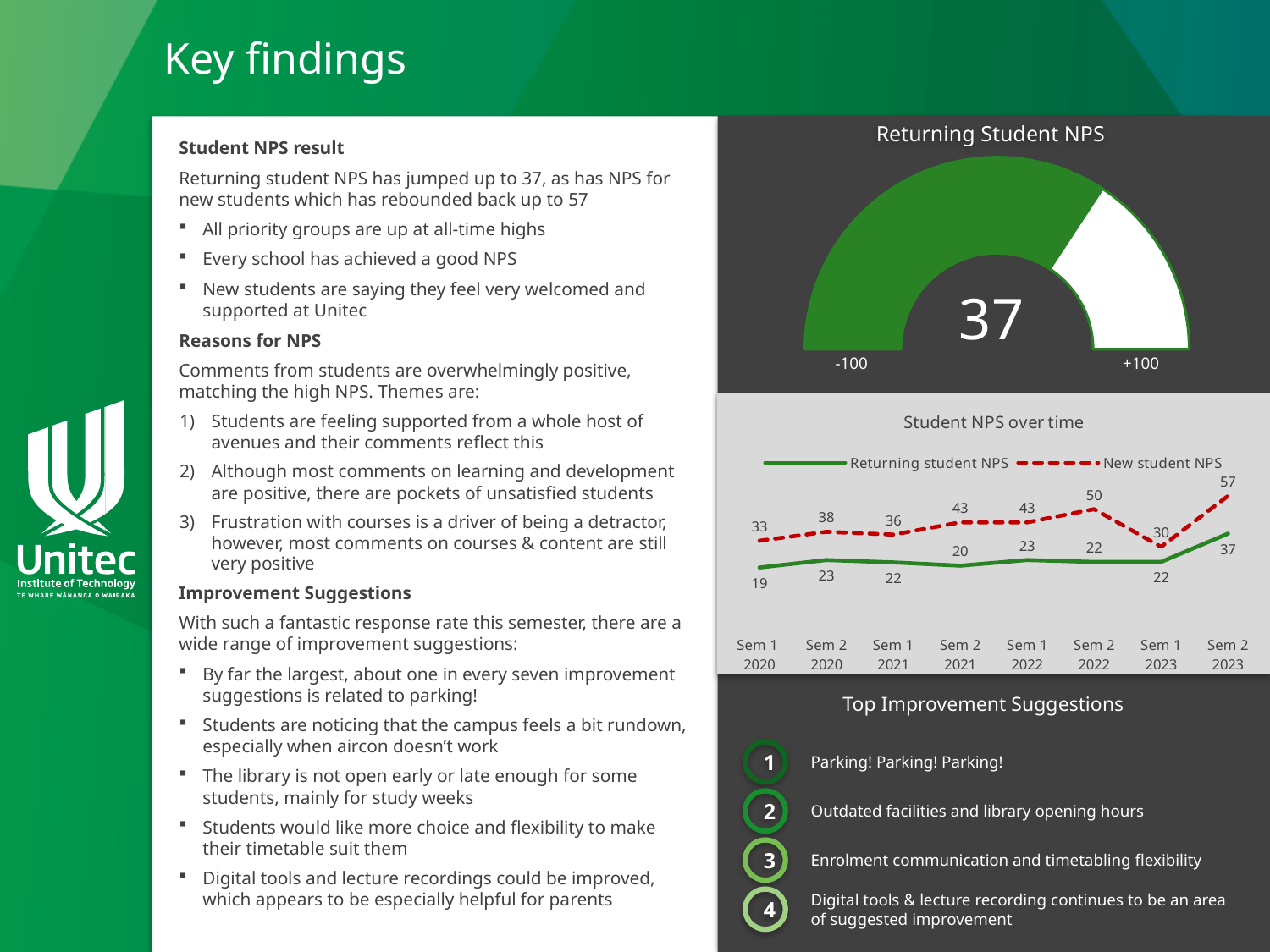
In the "Student NPS over time" chart, what is the New student NPS for Sem 1 2020? 33 What kind of chart is "Student NPS over time"? Line chart What are the minimum and maximum values labelled on the "Returning Student NPS" gauge? -100 and +100 In the "Student NPS over time" chart, what is the Returning student NPS for Sem 2 2023? 37 In the "Student NPS over time" chart, what is the difference between the New student NPS and the Returning student NPS in Sem 2 2023? 20 In the "Student NPS over time" chart, which semester has the lowest Returning student NPS? Sem 1 2020 How many series does the legend of the "Student NPS over time" chart list? 2 What value does the "Returning Student NPS" gauge chart show? 37 In the "Student NPS over time" chart, which is larger in Sem 1 2023: the New student NPS or the Returning student NPS? New student NPS How many semesters are shown on the x axis of the "Student NPS over time" chart? 8 In the "Student NPS over time" chart, which semester has the highest New student NPS? Sem 2 2023 In the "Student NPS over time" chart, what is the New student NPS for Sem 2 2022? 50